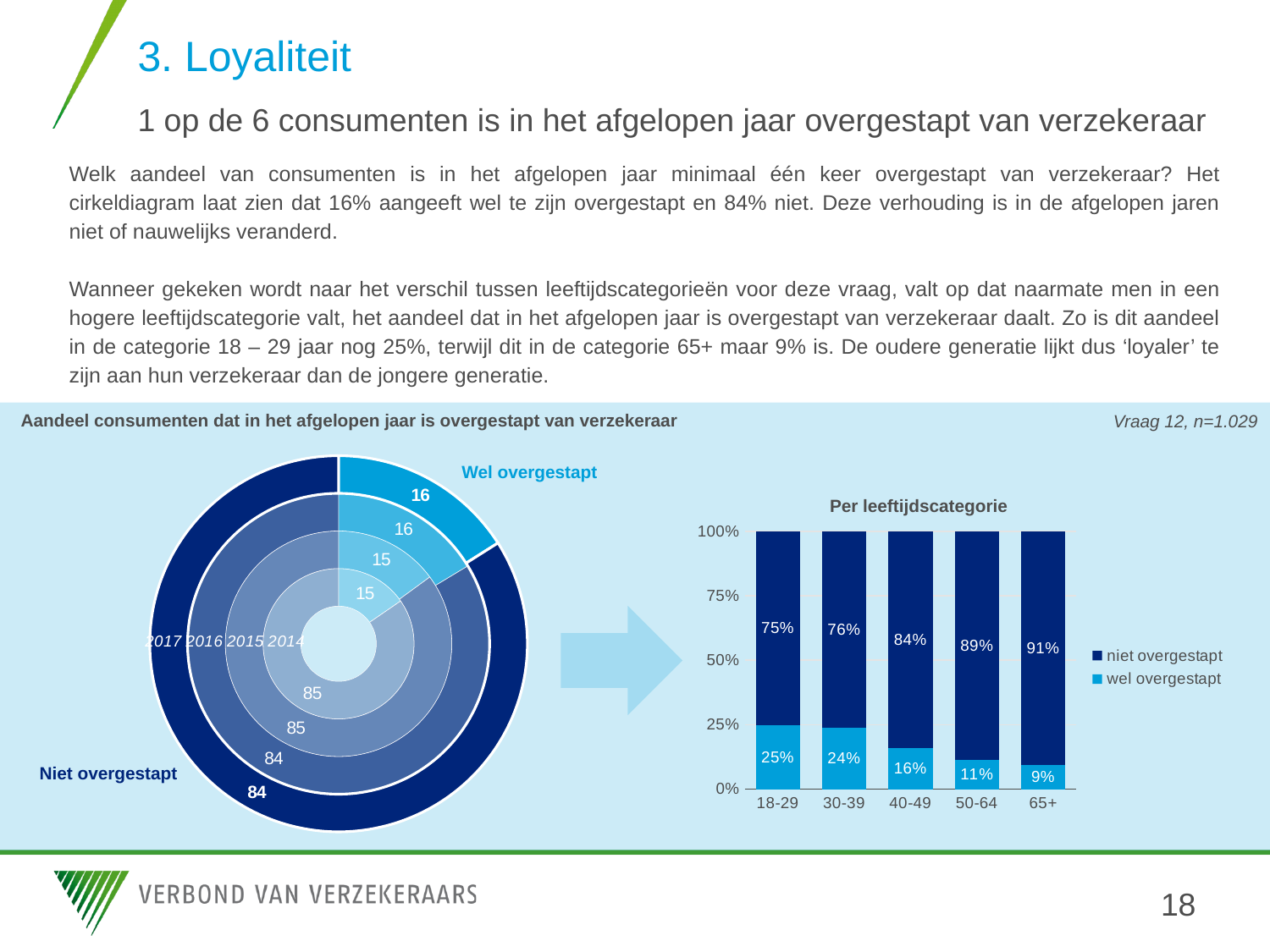
In the 'Per leeftijdscategorie' chart, what is the difference between the 'wel overgestapt' values for 18-29 and 65+? 16% In the 'Per leeftijdscategorie' chart, which age category has the highest share of 'wel overgestapt'? 18-29 In the 'Per leeftijdscategorie' chart, how many age categories are shown on the x axis? 5 In the 'Per leeftijdscategorie' chart, which age category has the lowest share of 'wel overgestapt'? 65+ In the 'Per leeftijdscategorie' chart, what is the value for 'niet overgestapt' in the 65+ category? 91% In the 'Per leeftijdscategorie' chart, is the 'niet overgestapt' value larger for 40-49 or for 50-64? 50-64 What kind of chart is the 'Per leeftijdscategorie' chart? Stacked bar chart In the 'Per leeftijdscategorie' chart, does the 'wel overgestapt' share rise or fall as the age categories go from 18-29 to 65+? Fall In the doughnut chart on the left, what is the 'Wel overgestapt' value for 2017 (the outer ring)? 16 In the doughnut chart on the left, what is the 'Niet overgestapt' value for 2015? 85 In the 'Per leeftijdscategorie' chart, how many series does the legend list? 2 In the 'Per leeftijdscategorie' chart, what is the value for 'wel overgestapt' in the 18-29 category? 25%